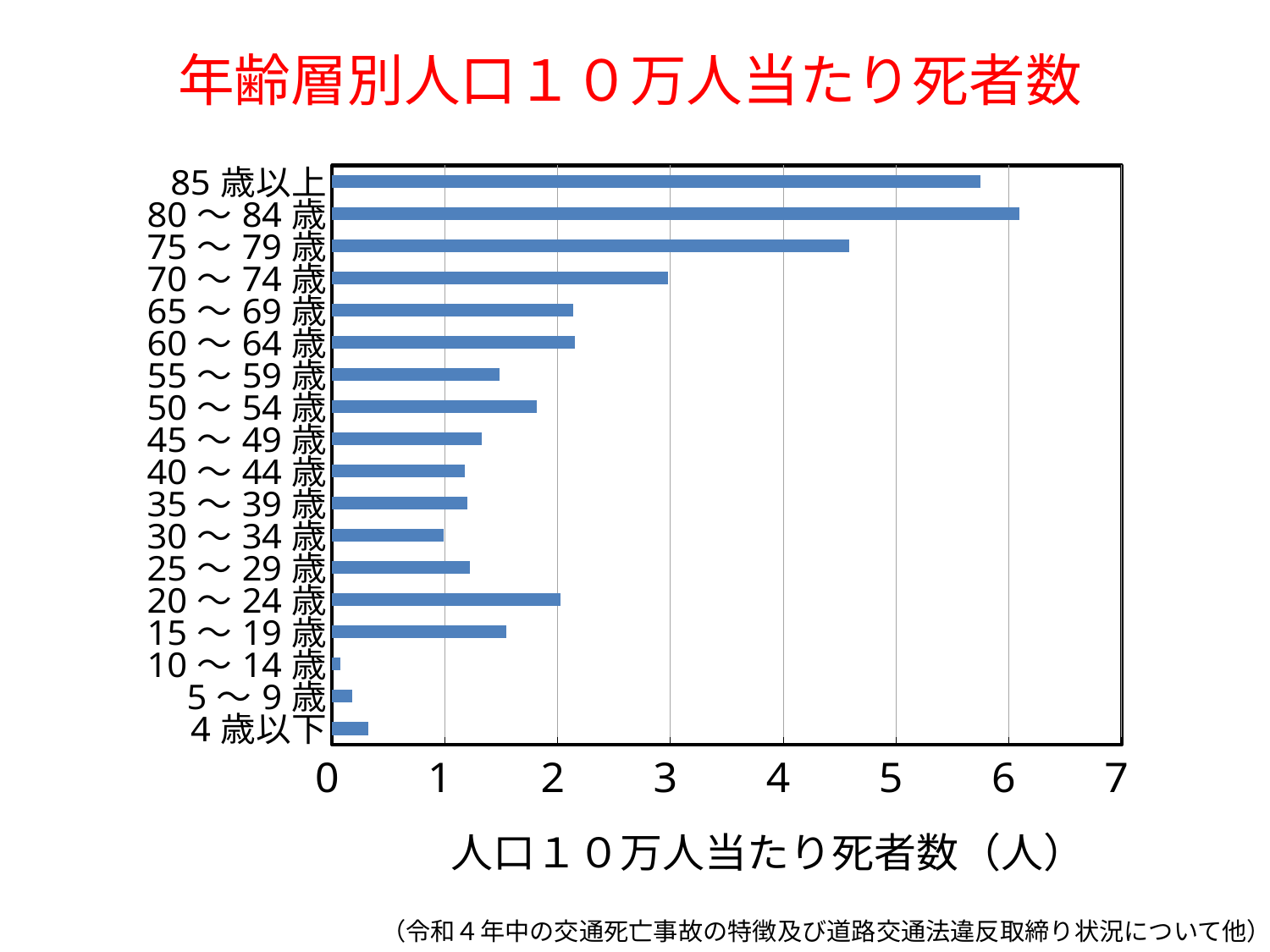
Which age group has the lowest number of deaths per 100,000 population? 10～14歳 Which has a larger value, 20～24歳 or 15～19歳? 20～24歳 What is the label of the horizontal axis? 人口１０万人当たり死者数（人） Is the value for 50～54歳 greater or less than 2? less Is the value for 75～79歳 greater or less than 4? greater Which age group has the highest number of deaths per 100,000 population? 80～84歳 What kind of chart is shown on the slide? bar chart What is the title of the chart? 年齢層別人口１０万人当たり死者数 How many age-group categories are plotted on the chart? 18 Which has a larger value, 75～79歳 or 70～74歳? 75～79歳 Is the value for 85歳以上 greater or less than 5? greater